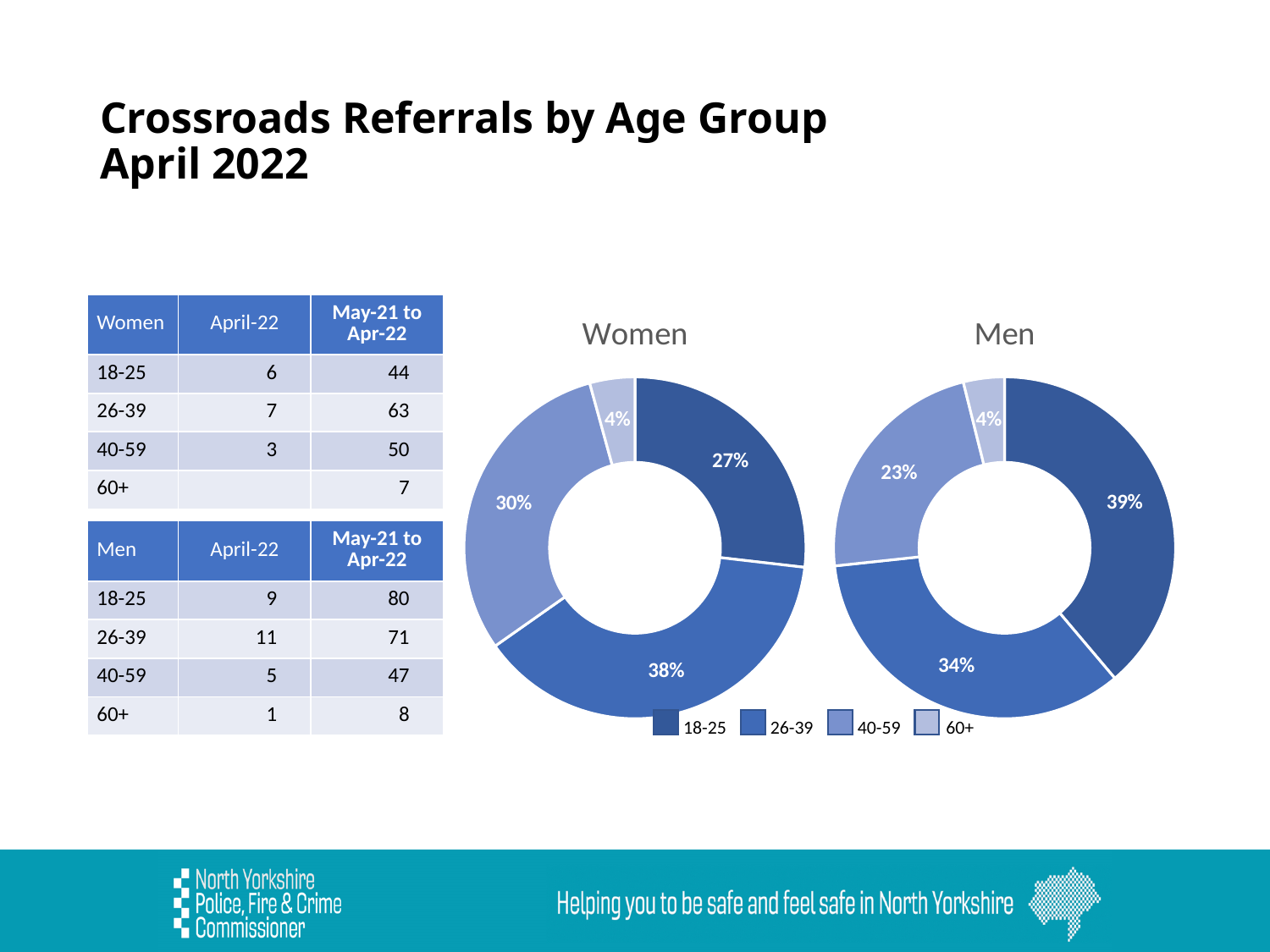
In the Men chart, which age group has the smallest share? 60+ In the Men chart, what share of referrals is the 18-25 age group? 39% Is the 18-25 share larger in the Women chart or the Men chart? Men In the Women chart, what is the difference in percentage points between the 26-39 and 18-25 shares? 11 How many age groups does the legend list for the doughnut charts? 4 In the Women chart, which age group has the largest share? 26-39 In the Women chart, what share of referrals is the 40-59 age group? 30% What type of chart is used to show the Women and Men referrals by age group? Doughnut chart In the Men chart, which age group has the largest share? 18-25 In the Women chart, what share of referrals is the 26-39 age group? 38% In the Men chart, what share of referrals is the 40-59 age group? 23% In the Men chart, what is the difference in percentage points between the 18-25 and 40-59 shares? 16